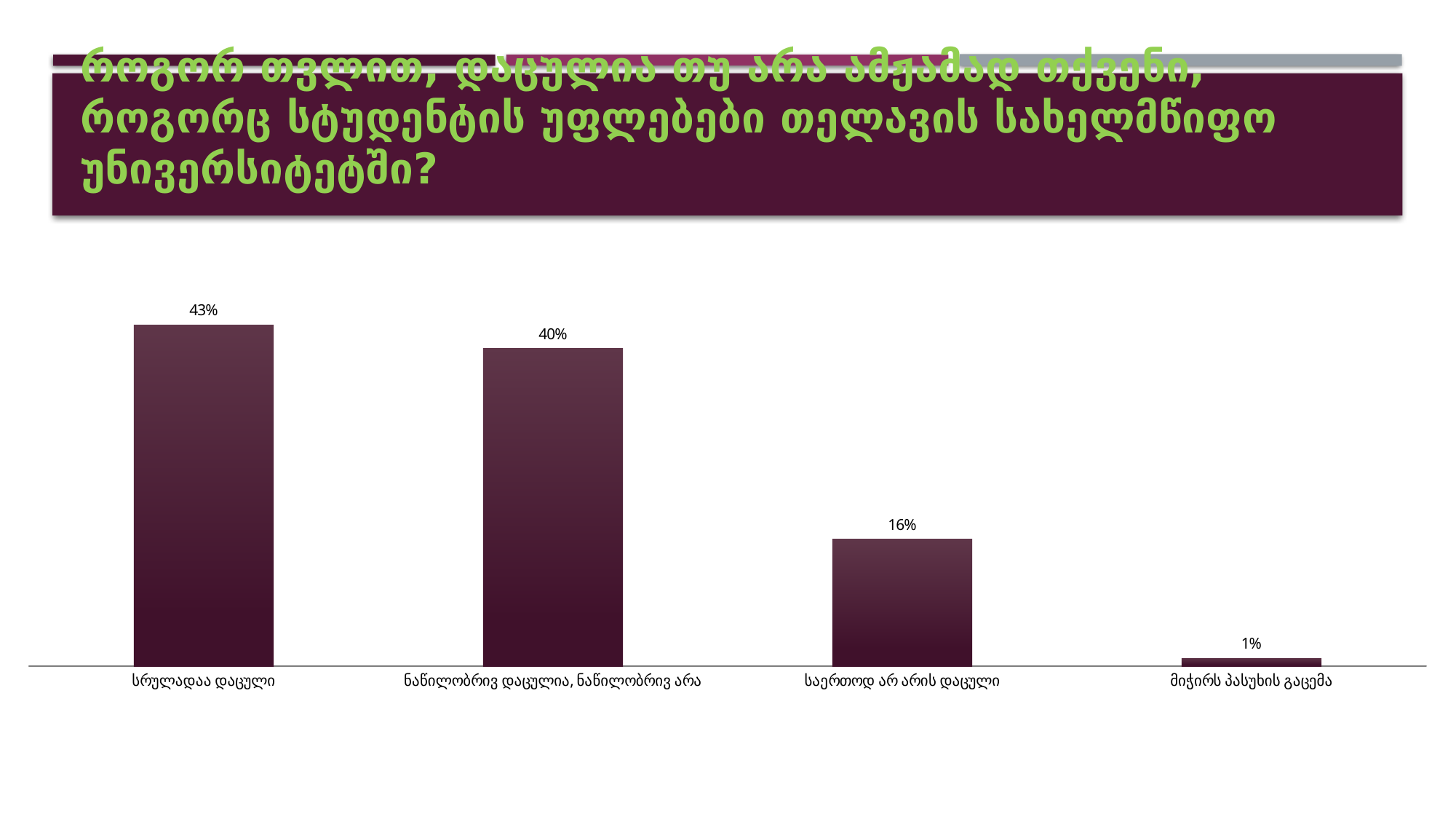
What is the value for "სრულადაა დაცული"? 43% What is the difference between the values for "ნაწილობრივ დაცულია, ნაწილობრივ არა" and "საერთოდ არ არის დაცული"? 24% What is the value for "საერთოდ არ არის დაცული"? 16% What kind of chart is shown on the slide? Bar chart Which category has the lowest value? მიჭირს პასუხის გაცემა Which category has the highest value? სრულადაა დაცული What is the difference between the values for "სრულადაა დაცული" and "ნაწილობრივ დაცულია, ნაწილობრივ არა"? 3% What is the value for "მიჭირს პასუხის გაცემა"? 1% How many categories are shown in the chart? 4 What is the value for "ნაწილობრივ დაცულია, ნაწილობრივ არა"? 40% Do the values rise or fall from left to right across the categories? Fall Which is larger, the value for "საერთოდ არ არის დაცული" or the value for "მიჭირს პასუხის გაცემა"? საერთოდ არ არის დაცული